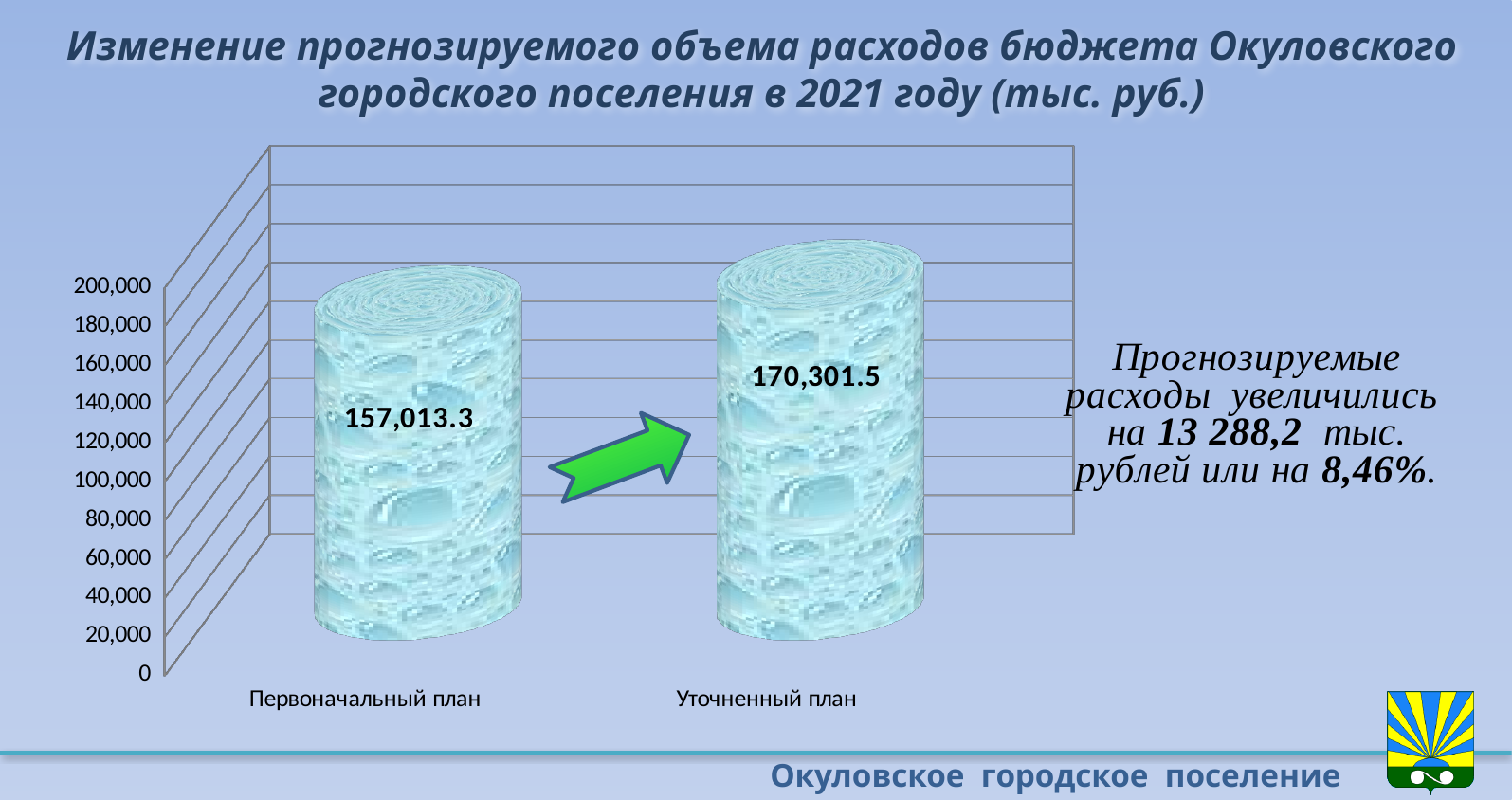
Do the values rise or fall from Первоначальный план to Уточненный план? rise How many categories are shown on the chart? 2 Is the value for Первоначальный план greater or less than 160,000? less What is the value for Уточненный план? 170,301.5 What is the difference between the values for Уточненный план and Первоначальный план? 13,288.2 Is the value for Уточненный план greater or less than 160,000? greater What kind of chart is shown on the slide? bar chart Which is larger, the value for Первоначальный план or the value for Уточненный план? Уточненный план What is the value for Первоначальный план? 157,013.3 What is the highest tick value shown on the vertical axis? 200,000 Which category has the highest value? Уточненный план Which category has the lowest value? Первоначальный план